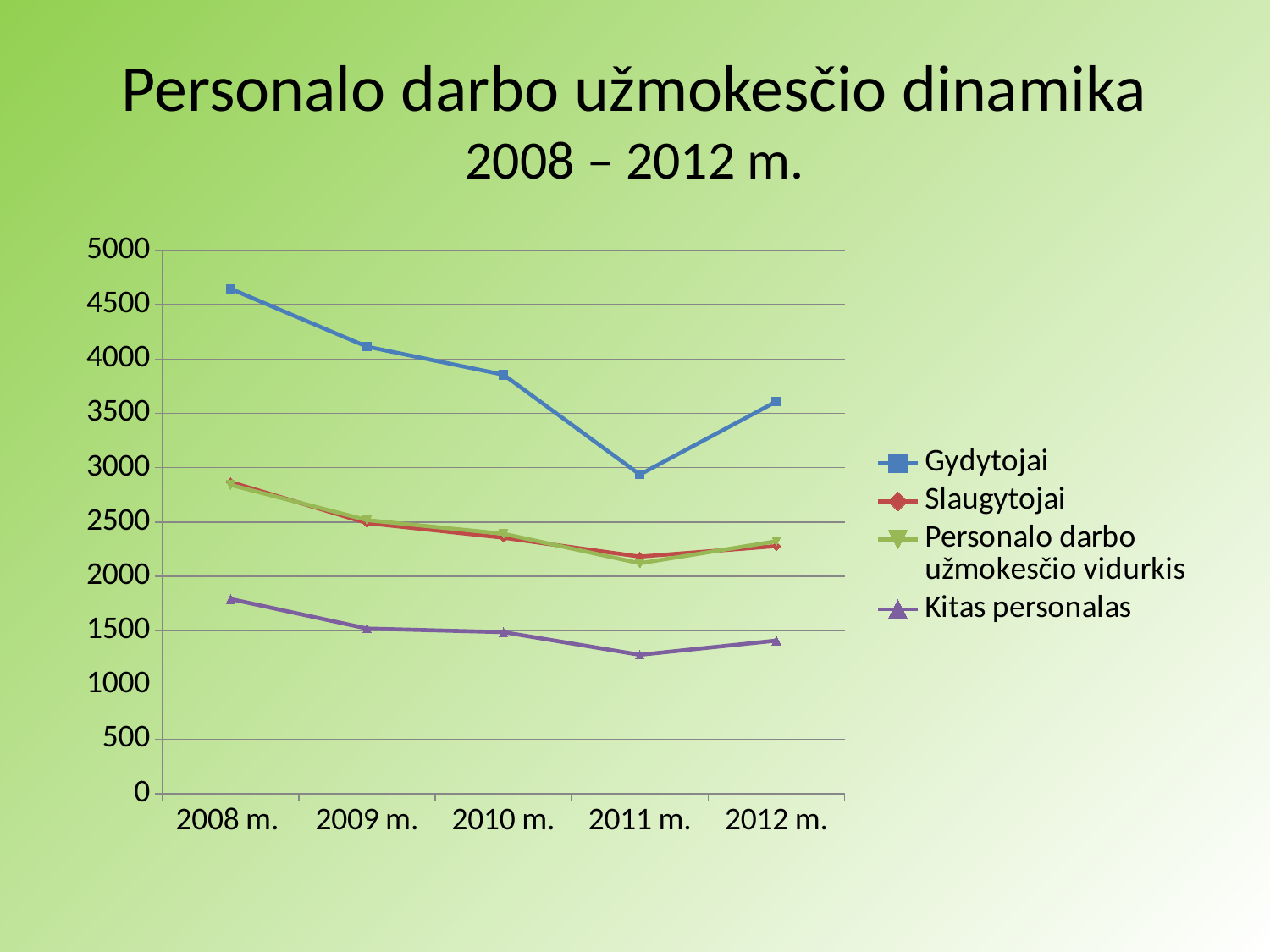
Is the value for Kitas personalas in 2008 m. greater or less than 1500? greater Is the value for Gydytojai in 2008 m. greater or less than 4500? greater In which year is the value for Gydytojai lowest? 2011 m. What is the title of the slide? Personalo darbo užmokesčio dinamika 2008 – 2012 m. Which series has the larger value in 2010 m., Gydytojai or Kitas personalas? Gydytojai How many series does the legend list? 4 Is the value for Gydytojai in 2011 m. greater or less than 3000? less In which year is the value for Gydytojai highest? 2008 m. In which year is the value for Kitas personalas lowest? 2011 m. Do the values for Kitas personalas rise or fall from 2008 m. to 2011 m.? fall How many years are shown on the x axis? 5 What kind of chart is shown on the slide? line chart